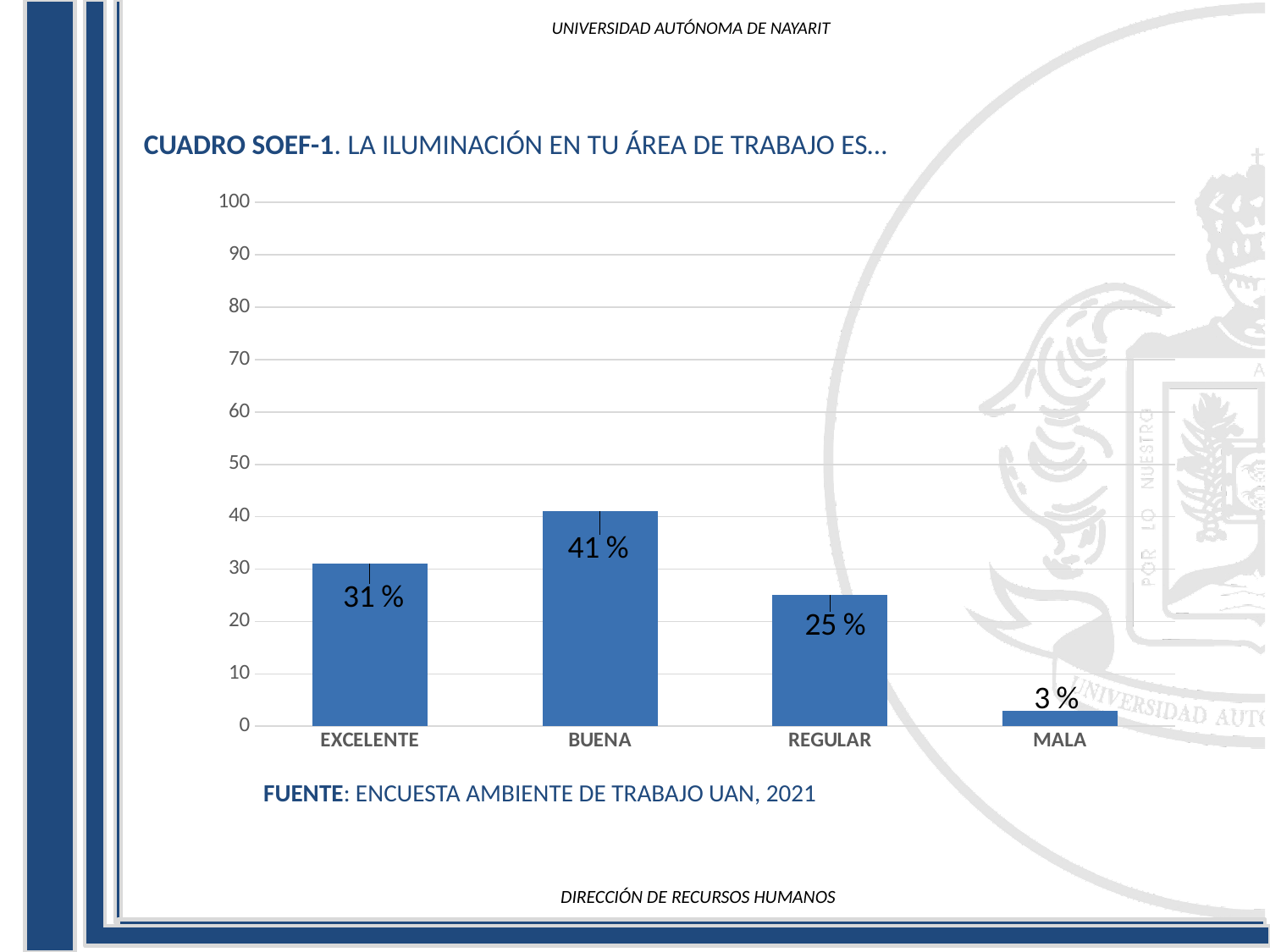
What is the value for MALA? 3 % How many categories are shown on the x axis? 4 Is the value for BUENA greater or less than 50? less What is the difference between the values for REGULAR and MALA? 22 % Which category has the highest value? BUENA What is the difference between the values for BUENA and EXCELENTE? 10 % What is the value for EXCELENTE? 31 % What is the value for BUENA? 41 % Which category has the lowest value? MALA What is the value for REGULAR? 25 % What kind of chart is shown on the slide? bar chart Which is larger, the value for EXCELENTE or the value for REGULAR? EXCELENTE